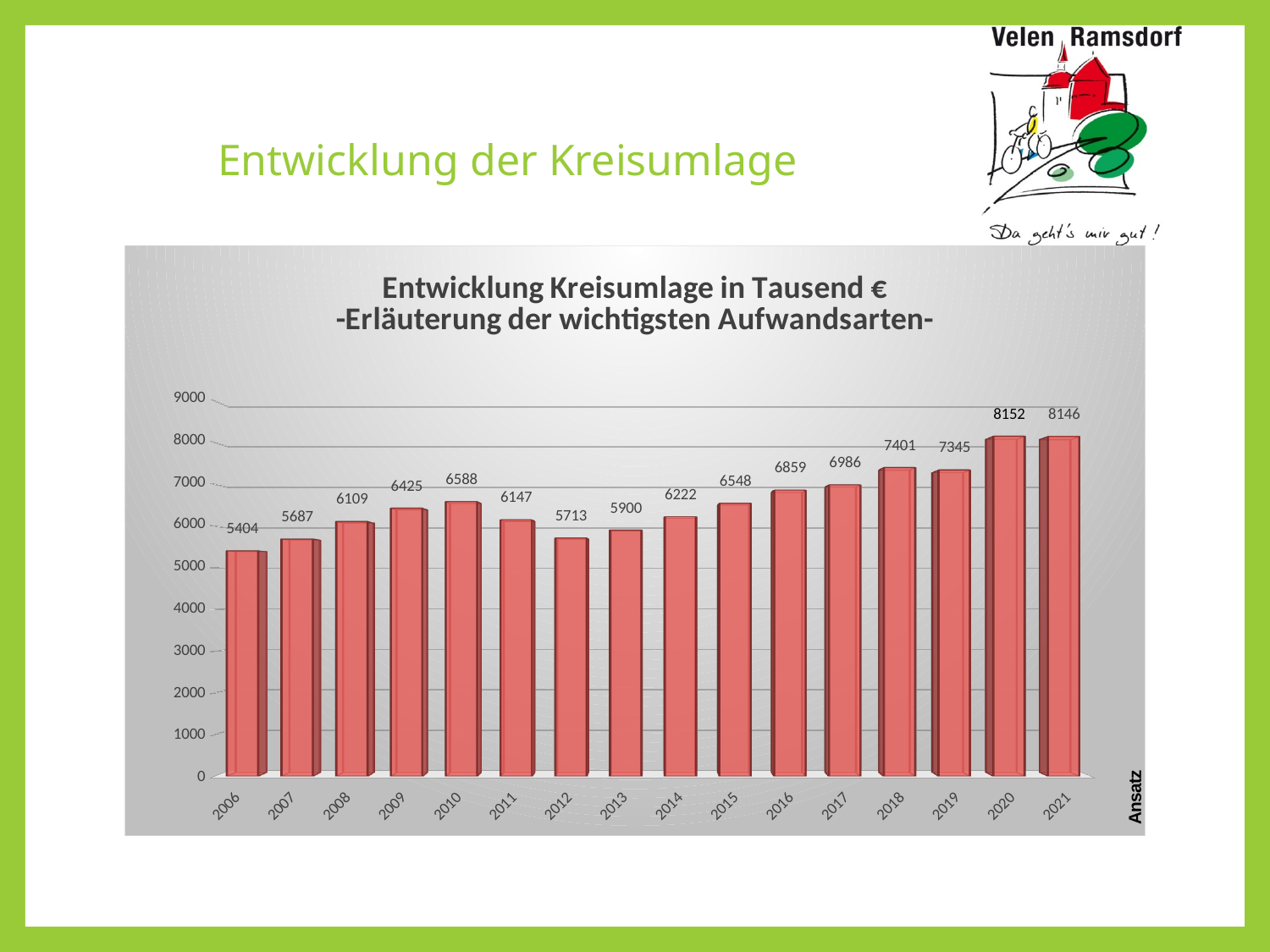
What is the difference between the values for 2021 and 2006? 2742 Do the values rise or fall from 2012 to 2020? rise Which is larger, the value for 2010 or the value for 2011? 2010 What kind of chart is this? bar chart What is the value for 2006? 5404 Which year has the highest value? 2020 What is the value for 2012? 5713 What is the title of the chart? Entwicklung Kreisumlage in Tausend € -Erläuterung der wichtigsten Aufwandsarten- Which year has the lowest value? 2006 Is the value for 2016 greater or less than 7000? less What is the value for 2018? 7401 How many years are shown on the x axis? 16